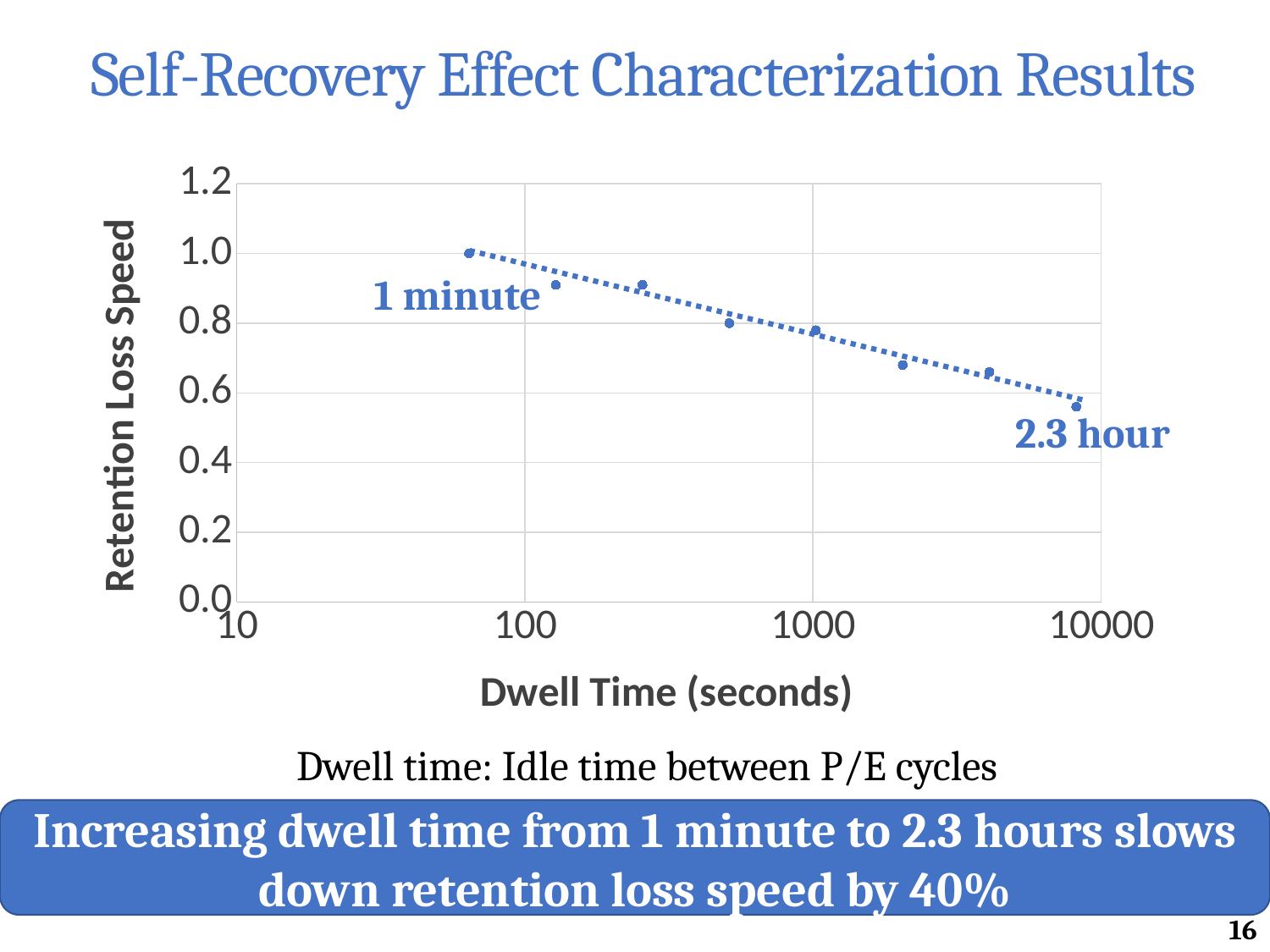
What is the label of the x axis? Dwell Time (seconds) How many data points are plotted in the chart? 8 Is the retention loss speed at the 1 minute dwell time greater or less than 0.8? greater Which labelled dwell time has the highest retention loss speed, 1 minute or 2.3 hour? 1 minute Is the retention loss speed at the 2.3 hour dwell time greater or less than 0.6? less Is the retention loss speed at the 1 minute dwell time larger or smaller than at the 2.3 hour dwell time? larger Is the retention loss speed at the 2.3 hour dwell time greater or less than 0.4? greater Does the retention loss speed rise or fall as dwell time increases along the x axis? fall Which labelled dwell time has the lowest retention loss speed, 1 minute or 2.3 hour? 2.3 hour What is the label of the y axis? Retention Loss Speed What kind of chart is shown on the slide? scatter chart